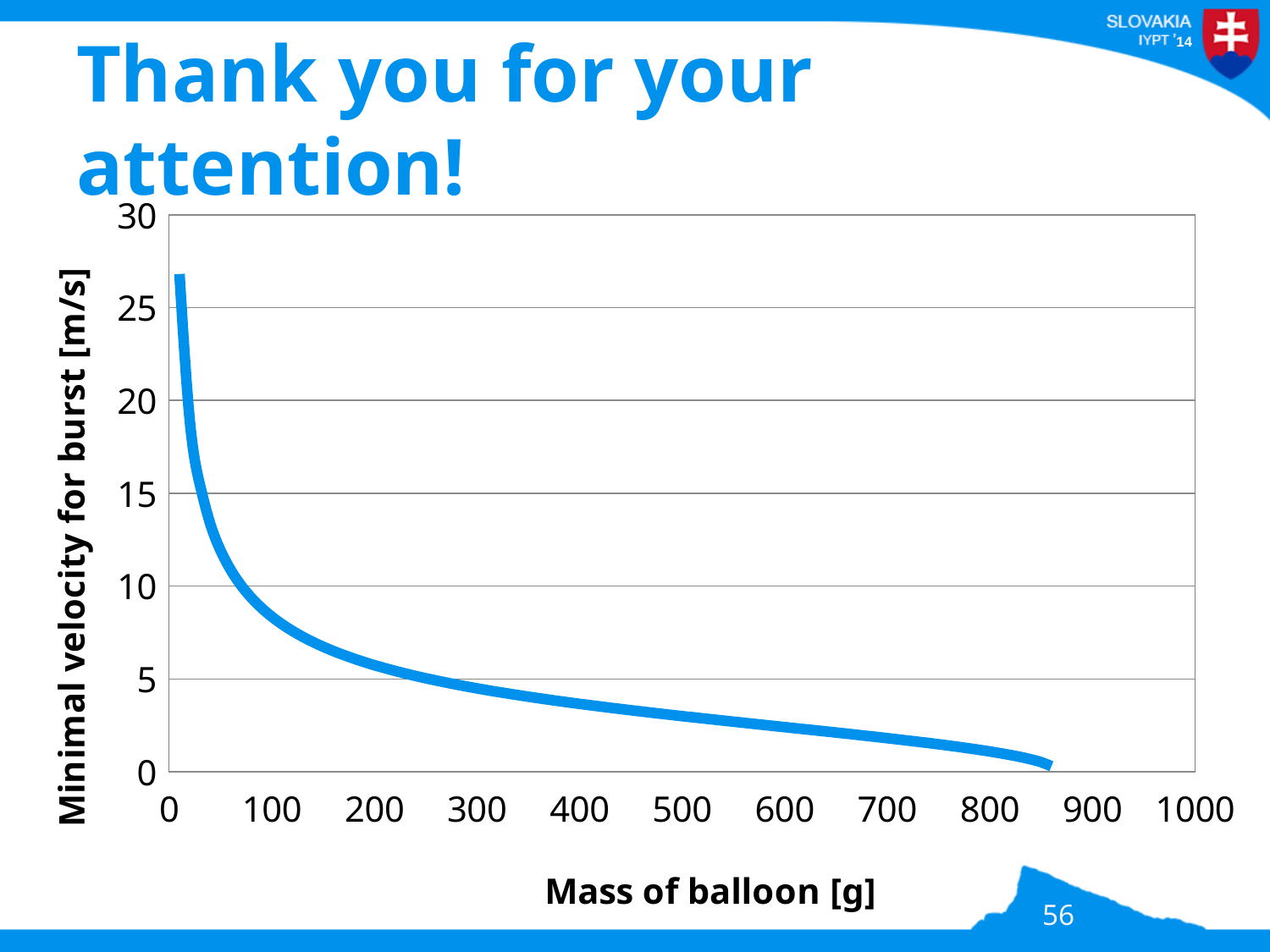
Is the minimal velocity for burst at a balloon mass of 500 g greater or less than 5 m/s? less Does the minimal velocity for burst rise or fall as the mass of balloon increases? fall What kind of chart is shown on the slide? line chart Which balloon mass has the larger minimal velocity for burst, 100 g or 500 g? 100 g Is the minimal velocity for burst at a balloon mass of 300 g greater or less than 10 m/s? less What is the label of the y axis of the chart? Minimal velocity for burst [m/s] Is the minimal velocity for burst at a balloon mass of 100 g greater or less than 10 m/s? less Which balloon mass has the larger minimal velocity for burst, 700 g or 200 g? 200 g What is the label of the x axis of the chart? Mass of balloon [g]